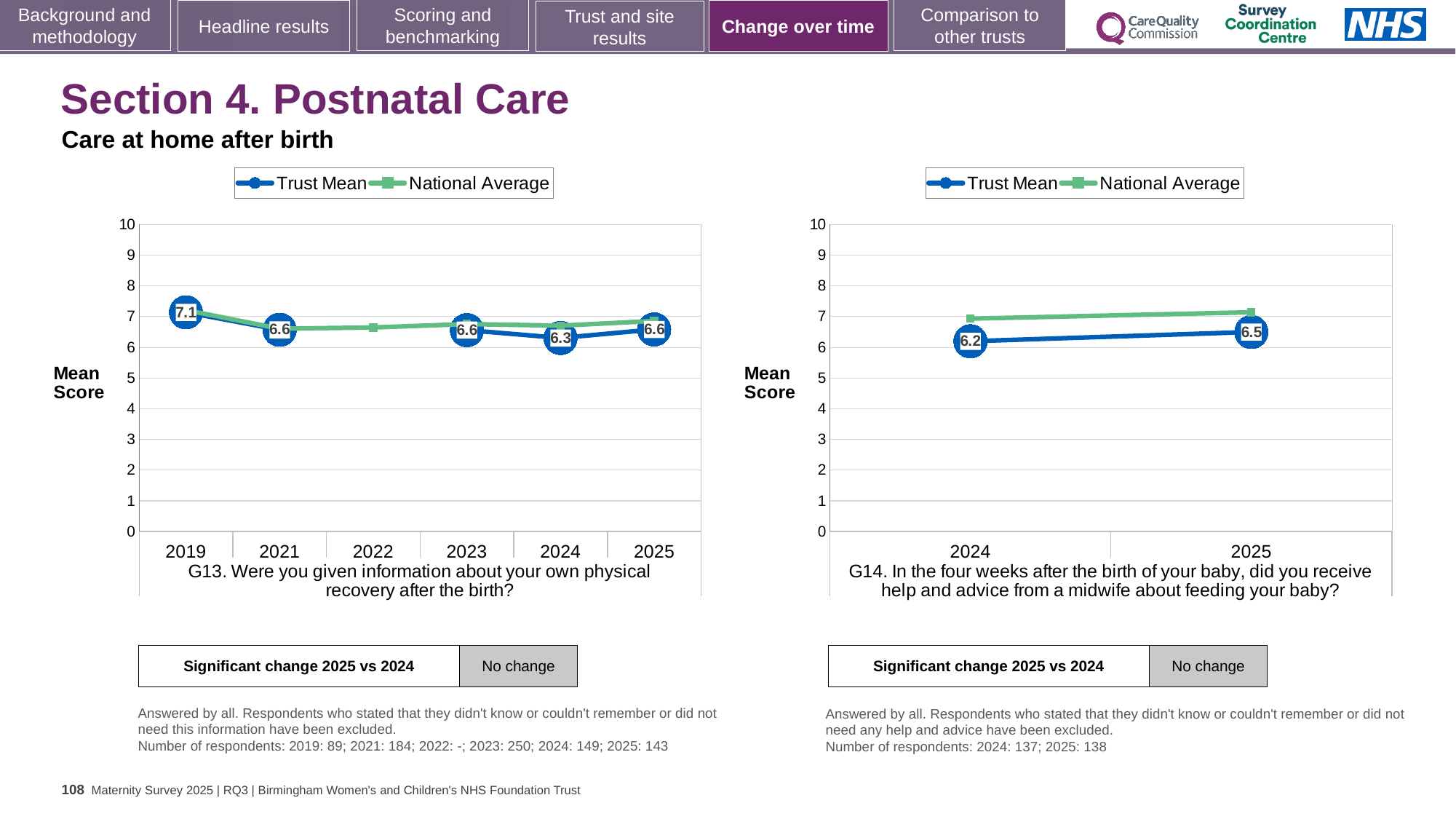
In the G13 chart (left), what is the Trust Mean score for 2024? 6.3 In the G14 chart (right), what is the Trust Mean score for 2025? 6.5 In the G13 chart (left), which year has the highest Trust Mean score? 2019 In the G14 chart (right), does the Trust Mean rise or fall from 2024 to 2025? rise How many series does the legend of the G13 chart (left) list? 2 In the G13 chart (left), which year has the lowest labelled Trust Mean score? 2024 In the G13 chart (left), what is the Trust Mean score for 2019? 7.1 In the G14 chart (right), what is the Trust Mean score for 2024? 6.2 In the G14 chart (right), is the National Average for 2025 greater or less than 6? greater In the G13 chart (left), what is the Trust Mean score for 2025? 6.6 What kind of chart is the G14 chart (right)? line chart In the G13 chart (left), what is the difference between the Trust Mean scores for 2019 and 2024? 0.8